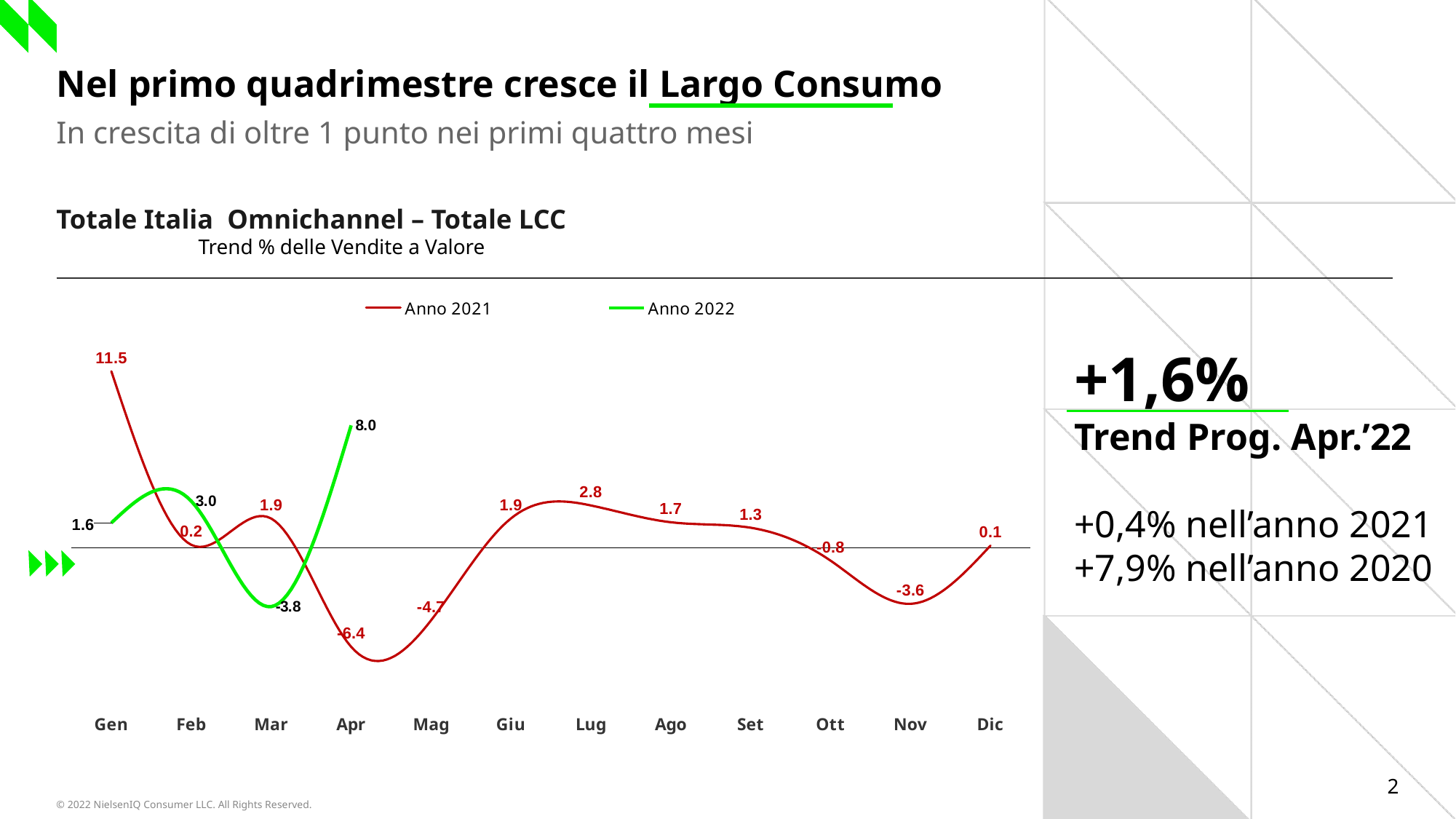
What is the value for Anno 2021 in Nov? -3.6 Which is larger in Feb: the Anno 2021 value or the Anno 2022 value? Anno 2022 Which month has the lowest value for Anno 2021? Apr What type of chart is shown on the slide? line chart How many series does the legend list? 2 What is the difference between the Anno 2022 and Anno 2021 values in Apr? 14.4 What is the value for Anno 2021 in Gen? 11.5 How many months are shown on the x axis? 12 What is the value for Anno 2022 in Mar? -3.8 What is the title of the chart? Totale Italia Omnichannel – Totale LCC Which month has the highest value for Anno 2021? Gen What is the value for Anno 2022 in Apr? 8.0